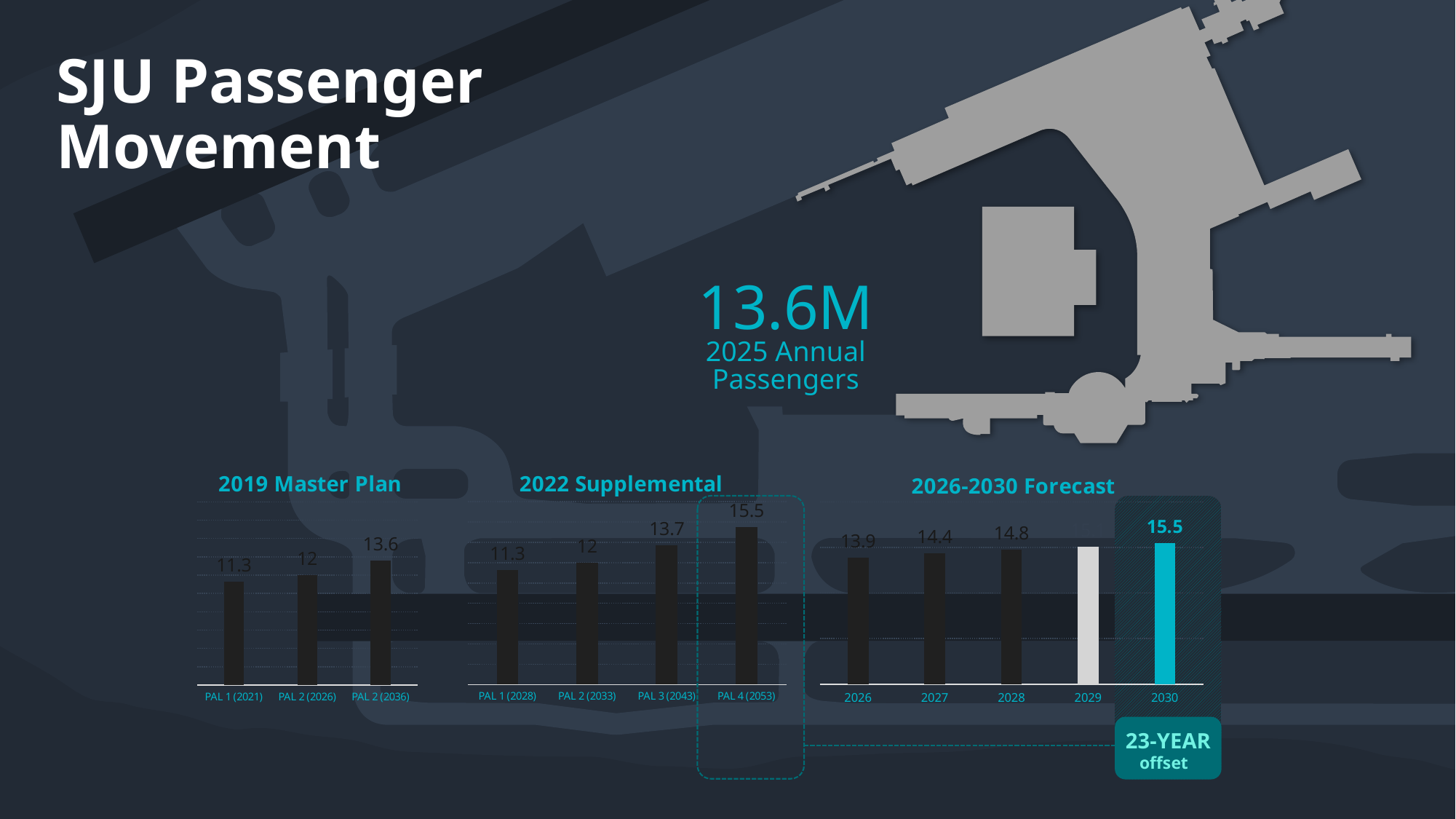
In the 2022 Supplemental chart, what is the difference between PAL 4 (2053) and PAL 1 (2028)? 4.2 In the 2022 Supplemental chart, which category has the highest value? PAL 4 (2053) In the 2022 Supplemental chart, what is the value for PAL 3 (2043)? 13.7 In the 2026-2030 Forecast chart, which year has the lowest value? 2026 In the 2026-2030 Forecast chart, what is the value for 2027? 14.4 In the 2026-2030 Forecast chart, what is the value for 2030? 15.5 In the 2022 Supplemental chart, how many categories are shown? 4 In the 2026-2030 Forecast chart, do the values rise or fall from 2026 to 2030? rise In the 2019 Master Plan chart, what is the value for PAL 1 (2021)? 11.3 In the 2026-2030 Forecast chart, how many bars are plotted? 5 In the 2019 Master Plan chart, what is the value for PAL 2 (2036)? 13.6 What kind of chart is the 2019 Master Plan chart? bar chart